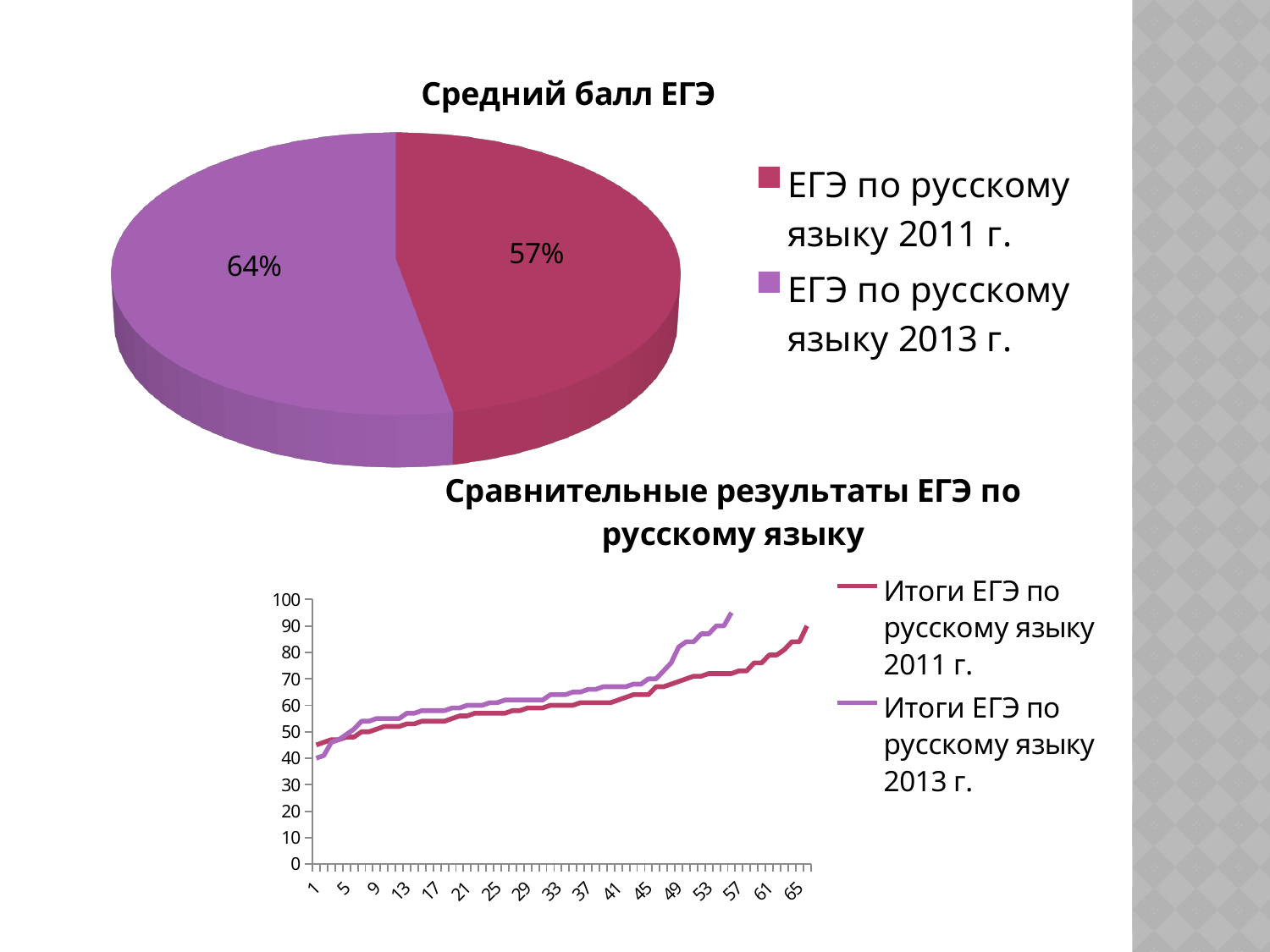
What kind of chart is the top chart 'Средний балл ЕГЭ'? Pie chart On the pie chart 'Средний балл ЕГЭ', which year has the higher value? ЕГЭ по русскому языку 2013 г. On the pie chart 'Средний балл ЕГЭ', what is the difference between the 2013 and 2011 values? 7% On the bottom chart 'Сравнительные результаты ЕГЭ по русскому языку', how many series does the legend list? 2 What kind of chart is the bottom chart 'Сравнительные результаты ЕГЭ по русскому языку'? Line chart On the bottom chart 'Сравнительные результаты ЕГЭ по русскому языку', at point 49, which series has the larger value? Итоги ЕГЭ по русскому языку 2013 г. On the bottom chart 'Сравнительные результаты ЕГЭ по русскому языку', do the values of the 2011 series rise or fall along the x axis? Rise On the pie chart 'Средний балл ЕГЭ', what value is shown for ЕГЭ по русскому языку 2013 г.? 64% On the pie chart 'Средний балл ЕГЭ', how many slices are there? 2 On the bottom chart 'Сравнительные результаты ЕГЭ по русскому языку', is the value of the 2013 series at point 21 greater or less than 70? less On the bottom chart 'Сравнительные результаты ЕГЭ по русскому языку', is the value of the 2011 series at point 65 greater or less than 80? greater On the pie chart 'Средний балл ЕГЭ', what value is shown for ЕГЭ по русскому языку 2011 г.? 57%